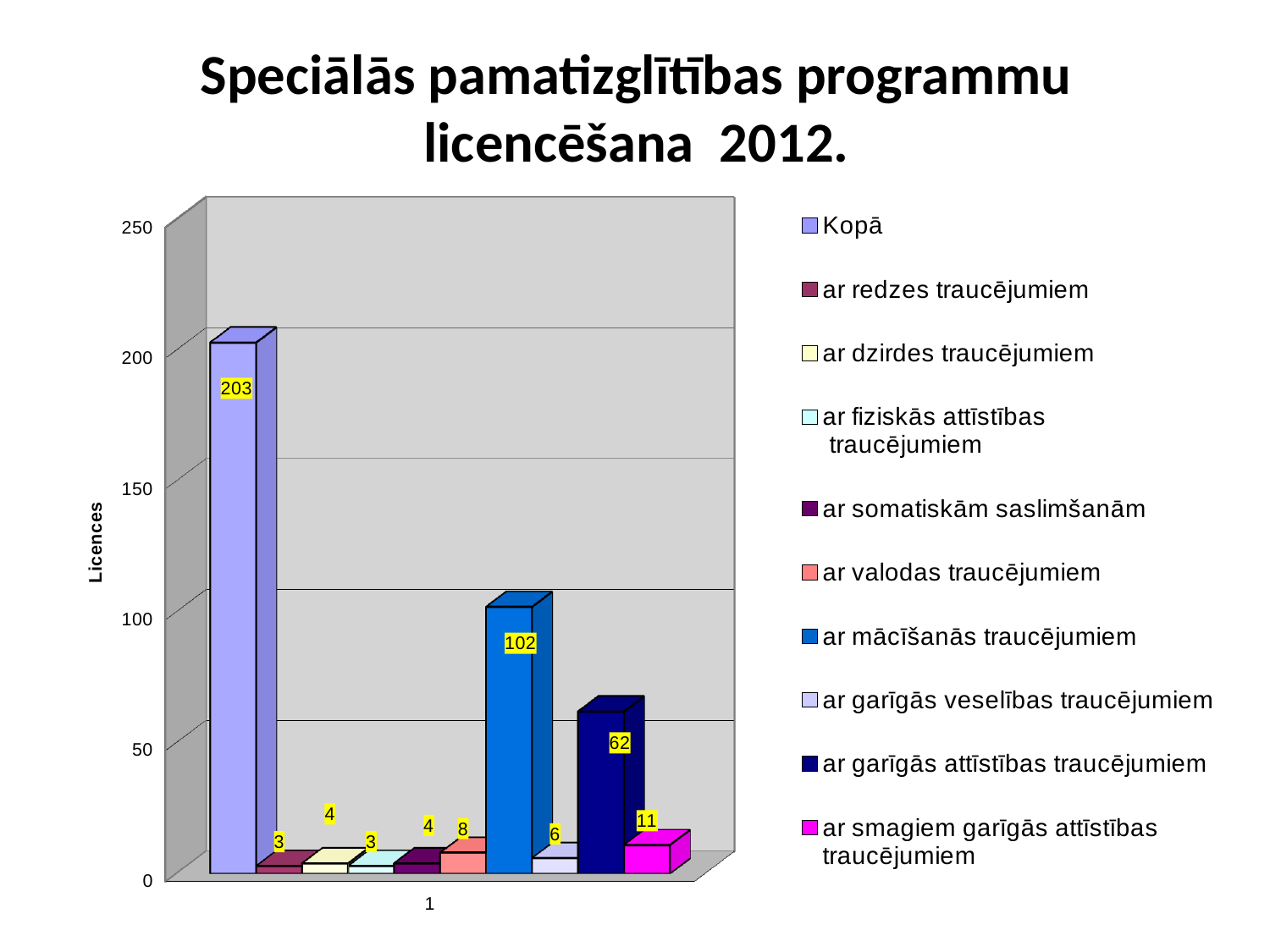
What is the value for ar valodas traucējumiem? 8 What kind of chart is shown on the slide? bar chart What is the value for Kopā? 203 What is the difference between the values for ar mācīšanās traucējumiem and ar garīgās attīstības traucējumiem? 40 What is the value for ar garīgās attīstības traucējumiem? 62 Which series has the highest value? Kopā Which is larger, the value for ar garīgās veselības traucējumiem or the value for ar smagiem garīgās attīstības traucējumiem? ar smagiem garīgās attīstības traucējumiem Is the value for ar mācīšanās traucējumiem greater or less than 100? greater What is the value for ar smagiem garīgās attīstības traucējumiem? 11 What is the label of the vertical axis? Licences How many series does the legend list? 10 What is the value for ar mācīšanās traucējumiem? 102